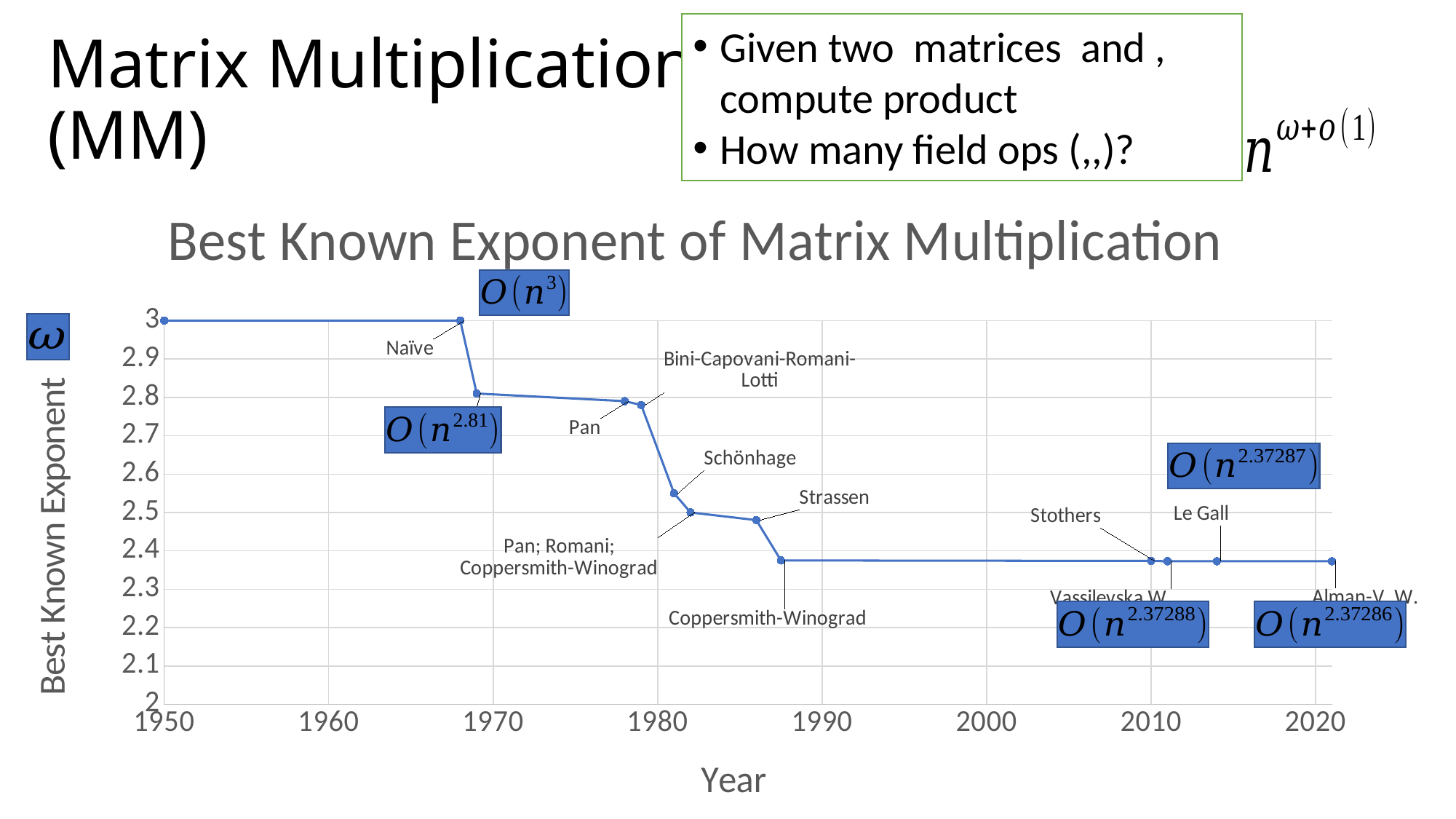
Is the value for the point labelled Coppersmith-Winograd (around 1987) greater or less than 2.4? less Is the value for the point labelled Schönhage (around 1981) greater or less than 2.5? greater Is the value plotted for 1978 greater or less than 2.7? greater What is the highest value plotted on the chart? 3 What is the title of the chart? Best Known Exponent of Matrix Multiplication What kind of chart is shown on the slide? line chart Do the plotted values rise or fall as the year increases? fall What is the label of the x axis of the chart? Year What is the best known exponent plotted for the year 1950? 3 Which has the larger value: the point at 1968 or the point at 1987? 1968 What is the value of the point labelled Naïve? 3